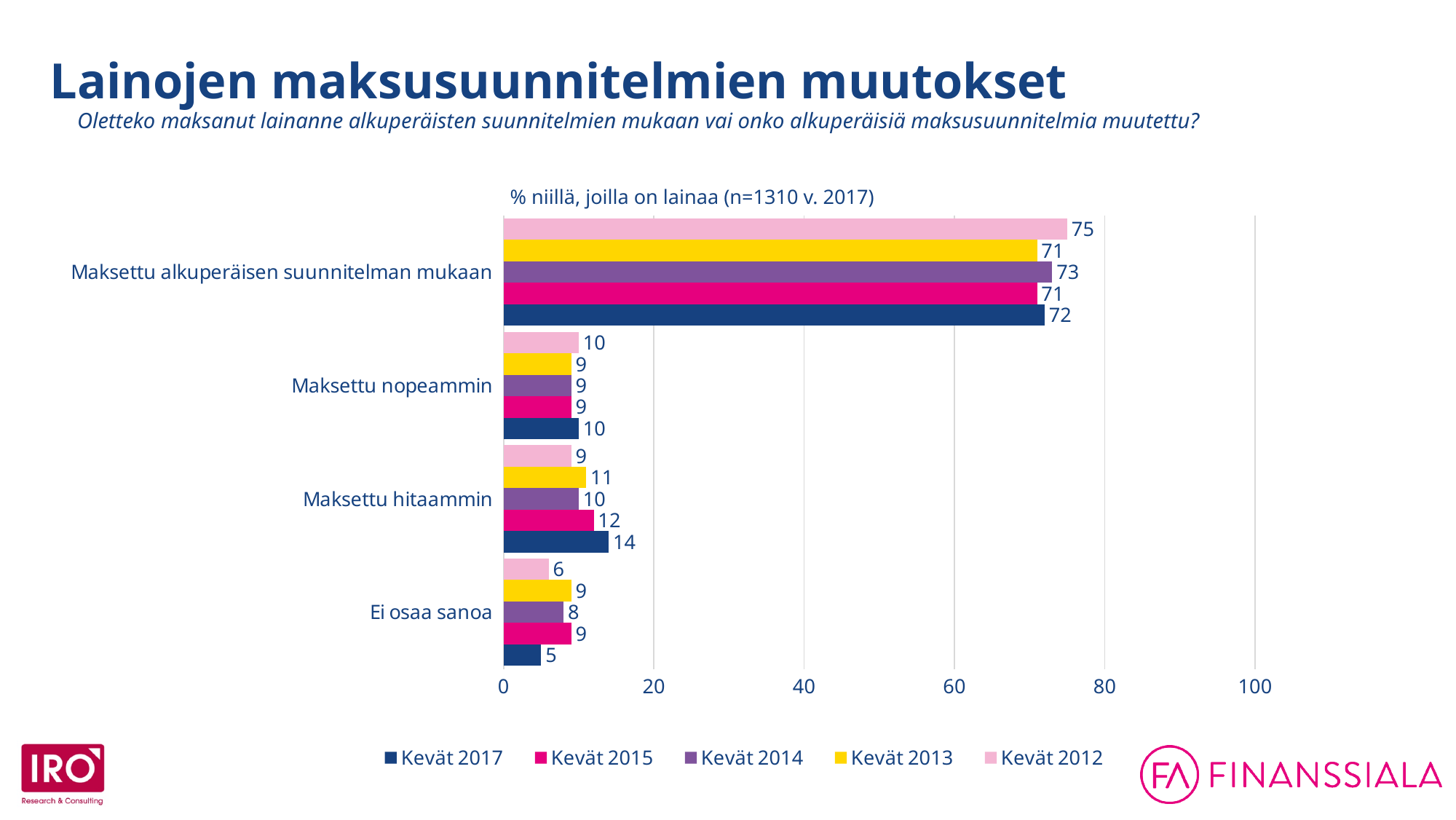
Which colour represents Kevät 2013 in the chart? Yellow What is the difference between the Kevät 2017 and Kevät 2012 values in the category "Maksettu hitaammin"? 5 In the category "Maksettu hitaammin", which is larger: the Kevät 2017 value or the Kevät 2013 value? Kevät 2017 What kind of chart is shown on the slide? Bar chart What is the value for Kevät 2017 in the category "Ei osaa sanoa"? 5 How many series does the legend list? 5 Which series has the highest value in the category "Maksettu alkuperäisen suunnitelman mukaan"? Kevät 2012 What is the value for Kevät 2017 in the category "Maksettu alkuperäisen suunnitelman mukaan"? 72 What is the value for Kevät 2012 in the category "Maksettu alkuperäisen suunnitelman mukaan"? 75 Which series has the lowest value in the category "Ei osaa sanoa"? Kevät 2017 What is the value for Kevät 2015 in the category "Maksettu hitaammin"? 12 How many categories are shown on the chart? 4